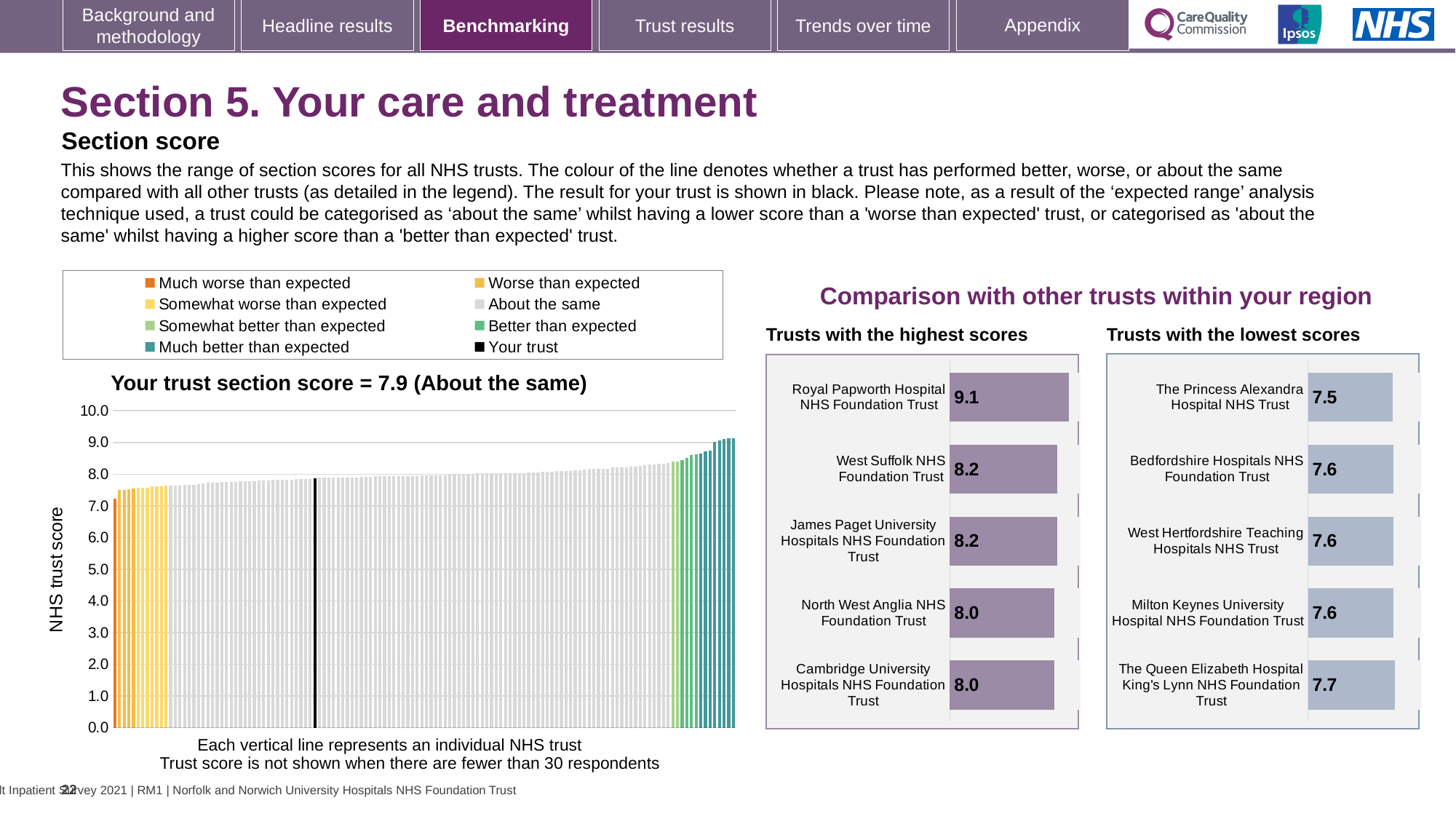
On the 'Trusts with the lowest scores' chart, which trust has the lowest score? The Princess Alexandra Hospital NHS Trust On the 'Trusts with the highest scores' chart, which trust has the highest score? Royal Papworth Hospital NHS Foundation Trust On the 'Trusts with the highest scores' chart, what is the score for Royal Papworth Hospital NHS Foundation Trust? 9.1 On the 'Trusts with the highest scores' chart, how many trusts are shown? 5 On the 'Trusts with the lowest scores' chart, what is the score for Milton Keynes University Hospital NHS Foundation Trust? 7.6 On the 'Trusts with the highest scores' chart, what is the difference between the scores of Royal Papworth Hospital NHS Foundation Trust and Cambridge University Hospitals NHS Foundation Trust? 1.1 On the 'Trusts with the lowest scores' chart, what is the difference between the scores of The Queen Elizabeth Hospital King's Lynn NHS Foundation Trust and The Princess Alexandra Hospital NHS Trust? 0.2 On the 'Trusts with the lowest scores' chart, which has the larger score: The Queen Elizabeth Hospital King's Lynn NHS Foundation Trust or The Princess Alexandra Hospital NHS Trust? The Queen Elizabeth Hospital King's Lynn NHS Foundation Trust On the main chart on the left, what is your trust's section score? 7.9 What kind of chart is the main chart on the left showing the range of section scores? Bar chart On the 'Trusts with the lowest scores' chart, what is the score for The Princess Alexandra Hospital NHS Trust? 7.5 How many entries does the legend above the main chart on the left list? 8